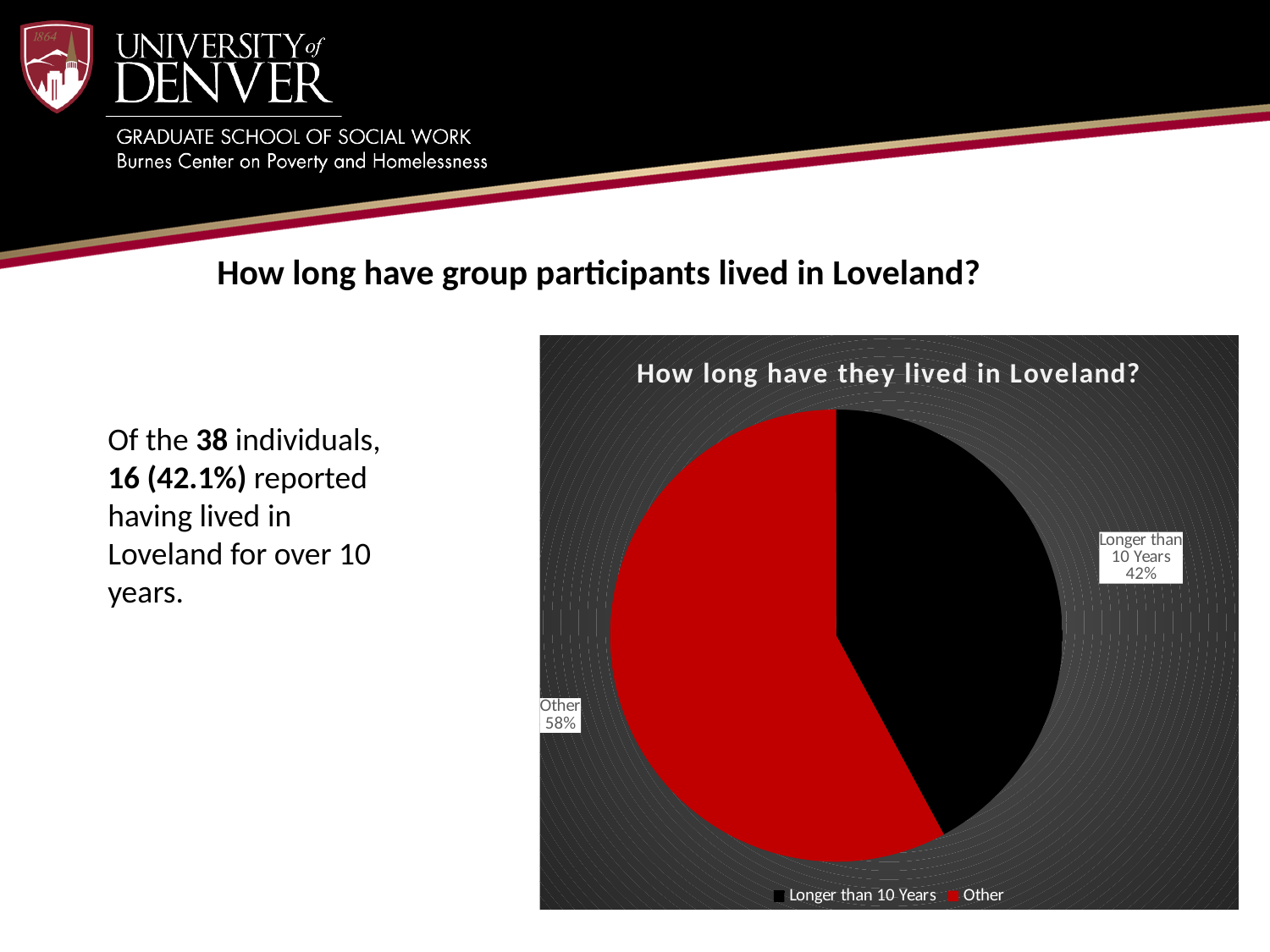
What share of the pie is labelled "Other"? 58% What is the title of the chart? How long have they lived in Loveland? What is the difference in percentage points between the "Other" slice and the "Longer than 10 Years" slice? 16 percentage points Which slice of the pie is the largest? Other What kind of chart is shown on the slide? pie chart How many slices does the pie chart have? 2 What colour is the "Other" slice in the pie chart? red Is the share for "Longer than 10 Years" greater or less than 50%? less How many entries does the legend list? 2 Which slice of the pie is the smallest? Longer than 10 Years Which is larger, the "Other" slice or the "Longer than 10 Years" slice? Other What share of the pie is labelled "Longer than 10 Years"? 42%